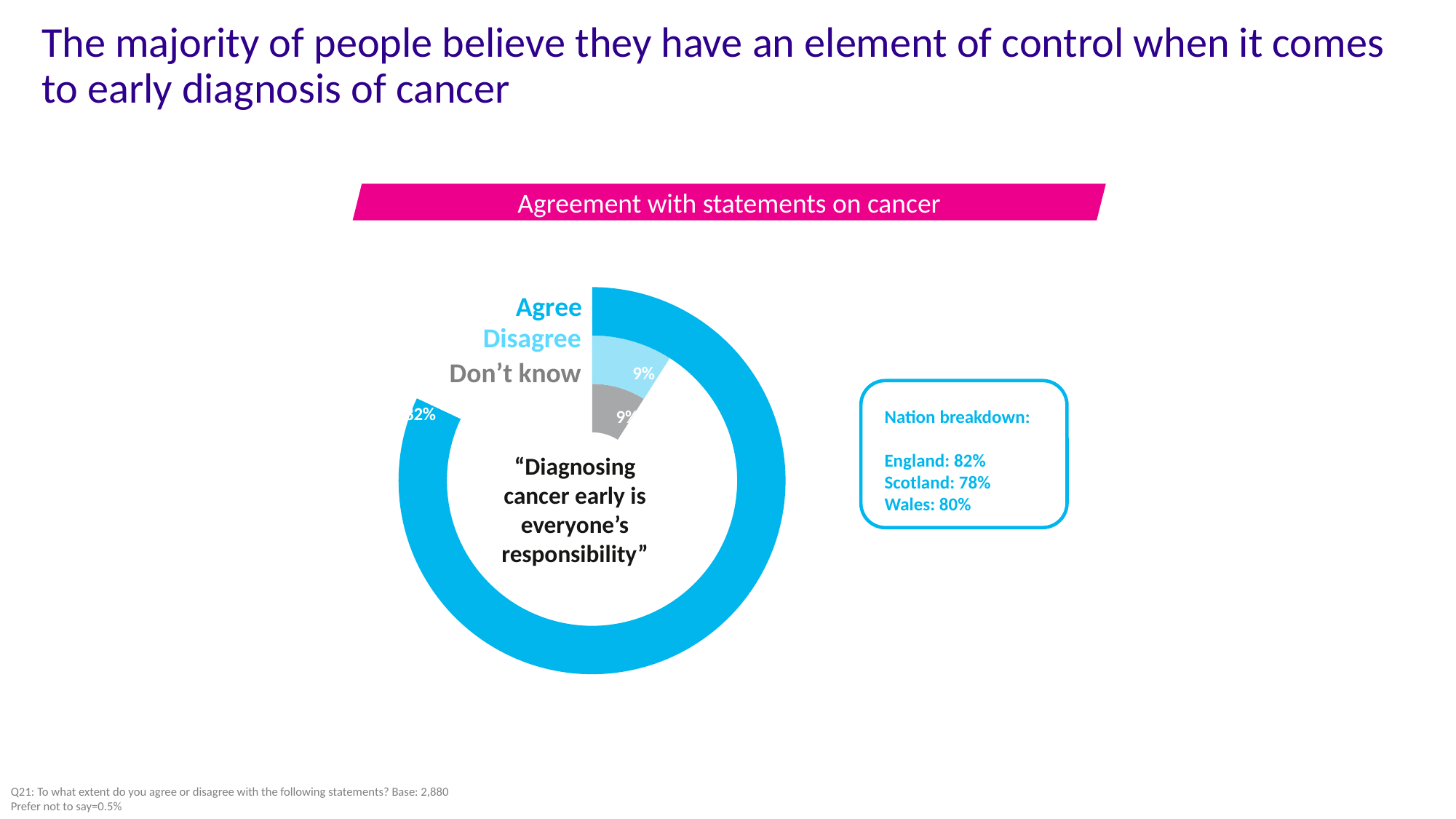
What statement is written in the centre of the donut chart? "Diagnosing cancer early is everyone's responsibility" What percentage of respondents disagree with the statement "Diagnosing cancer early is everyone's responsibility"? 9% What percentage of respondents answered "Don't know" to the statement "Diagnosing cancer early is everyone's responsibility"? 9% According to the nation breakdown box, what is the difference between the England and Scotland agreement figures? 4% What is the title shown in the pink banner above the chart? Agreement with statements on cancer According to the nation breakdown box, what is the agreement figure for Scotland? 78% Which is larger in the donut chart: the Agree share or the Disagree share? Agree Which response category has the largest share of the donut chart? Agree According to the nation breakdown box, which nation has the highest agreement figure? England How many response categories are shown in the donut chart? 3 What kind of chart is shown on the slide? Donut (pie) chart